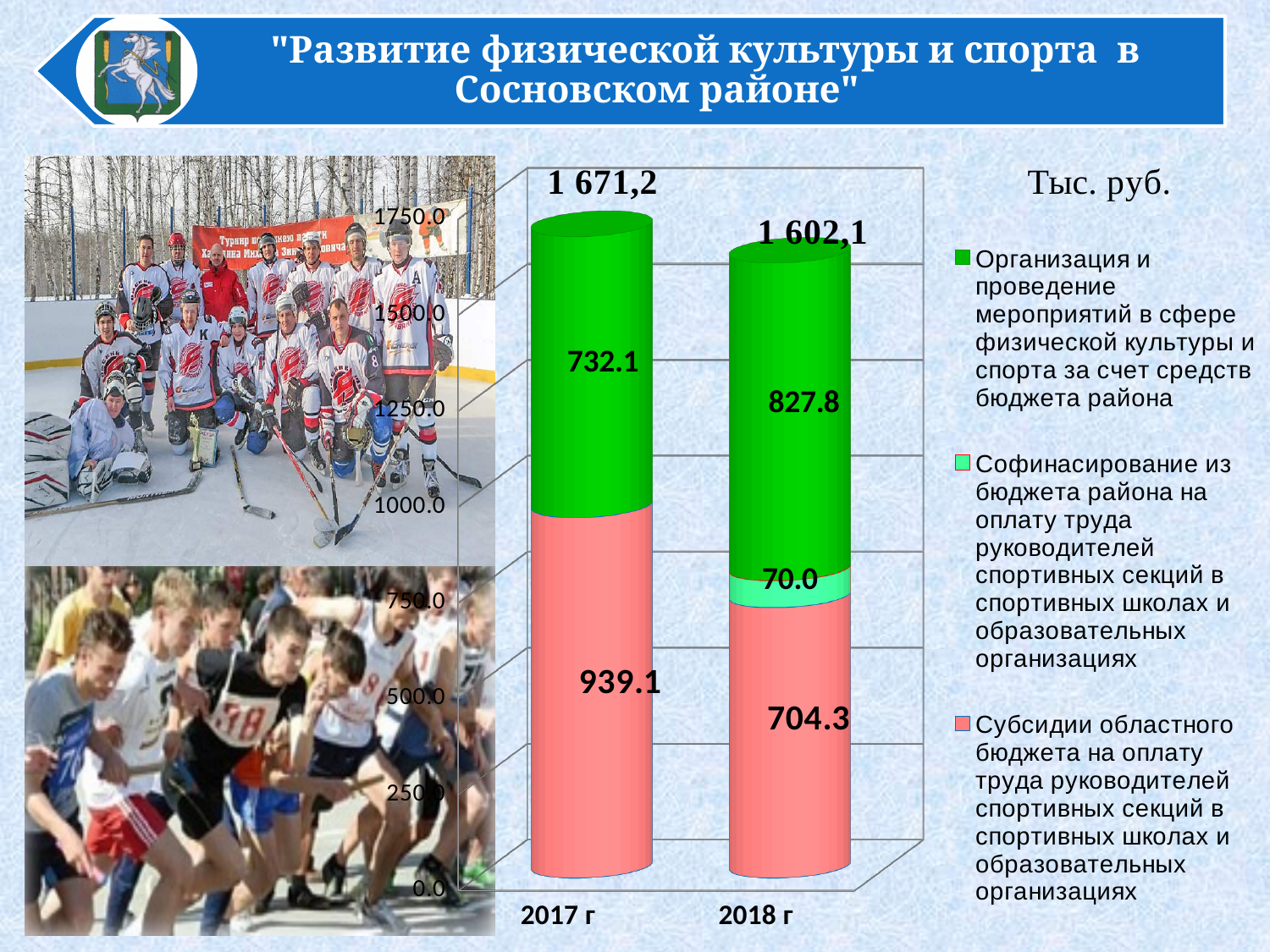
How many series does the chart legend list? 3 What is the value of the 'Организация и проведение мероприятий' segment for 2018 г? 827.8 What is the total shown above the bar for 2017 г? 1 671,2 What kind of chart is shown on the slide? stacked bar chart What is the total shown above the bar for 2018 г? 1 602,1 What is the difference between the 'Субсидии областного бюджета' values for 2017 г and 2018 г? 234.8 What unit of measurement is indicated next to the chart? Тыс. руб. How many categories (years) are shown on the x axis of the chart? 2 What is the value of the 'Субсидии областного бюджета' segment for 2017 г? 939.1 Does the total for the bars rise or fall from 2017 г to 2018 г? fall What is the value of the 'Софинасирование из бюджета района' segment for 2018 г? 70.0 Which year has the higher value for 'Организация и проведение мероприятий': 2017 г or 2018 г? 2018 г